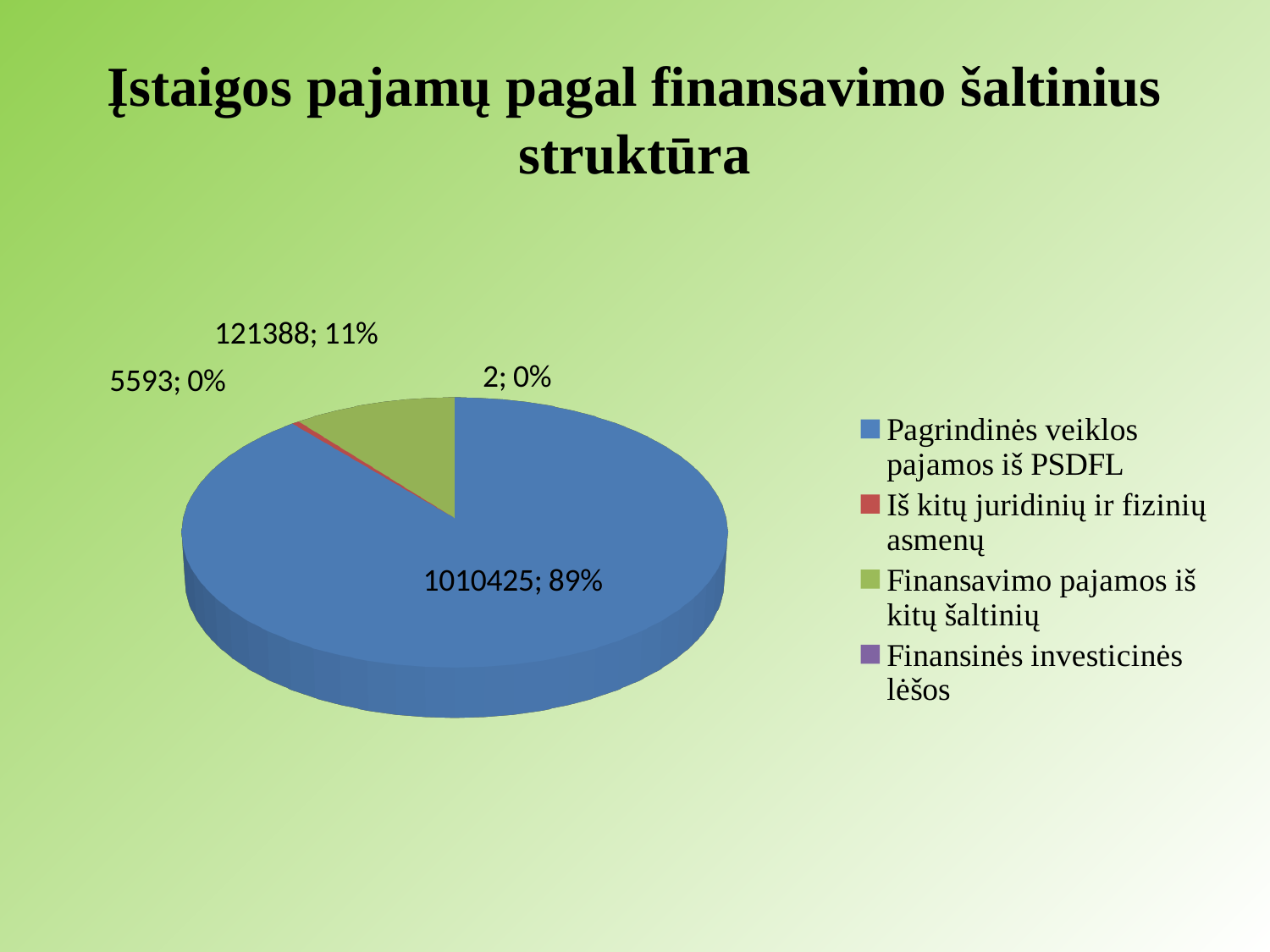
What is the value for Finansavimo pajamos iš kitų šaltinių? 121388 What kind of chart is shown on the slide? pie chart Which category has the smallest value? Finansinės investicinės lėšos What share of the pie does Finansavimo pajamos iš kitų šaltinių represent? 11% Which category has the largest slice of the pie? Pagrindinės veiklos pajamos iš PSDFL What is the value for Pagrindinės veiklos pajamos iš PSDFL? 1010425 How many categories does the legend list? 4 What share of the pie does Pagrindinės veiklos pajamos iš PSDFL represent? 89% What is the value for Iš kitų juridinių ir fizinių asmenų? 5593 What is the difference between the values for Pagrindinės veiklos pajamos iš PSDFL and Finansavimo pajamos iš kitų šaltinių? 889037 What is the title of the chart on the slide? Įstaigos pajamų pagal finansavimo šaltinius struktūra What is the value for Finansinės investicinės lėšos? 2